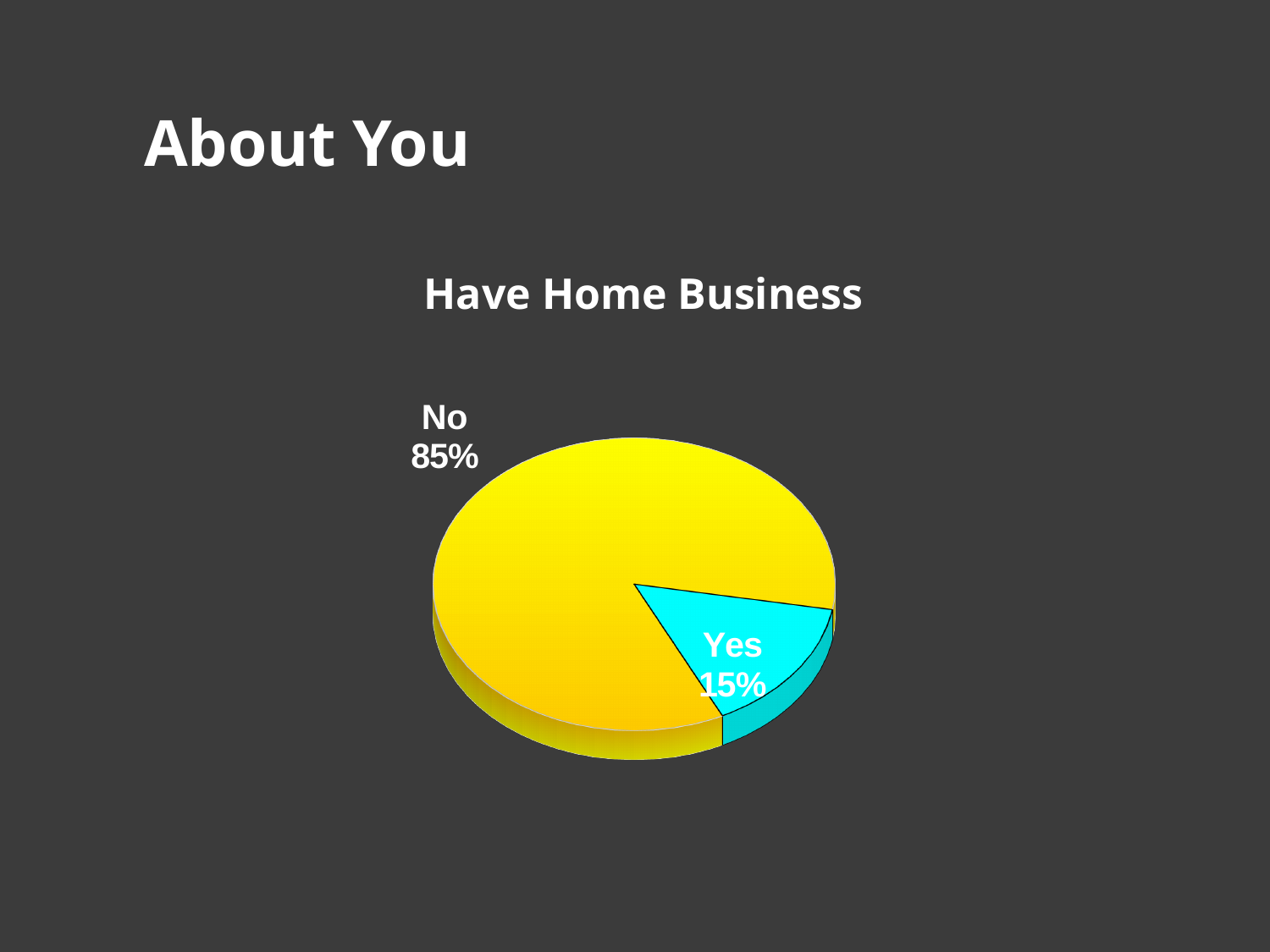
What is the title of the chart? Have Home Business What share of the pie does the "Yes" slice represent? 15% Which slice is the largest in the pie chart? No Which slice is the smallest in the pie chart? Yes What type of chart is shown on the slide? pie chart What is the difference in percentage points between the "No" and "Yes" slices? 70 What colour is the "Yes" slice? cyan Which is larger, the "Yes" slice or the "No" slice? No What percentage of respondents answered "No"? 85% What percentage of respondents answered "Yes"? 15% How many slices does the pie chart have? 2